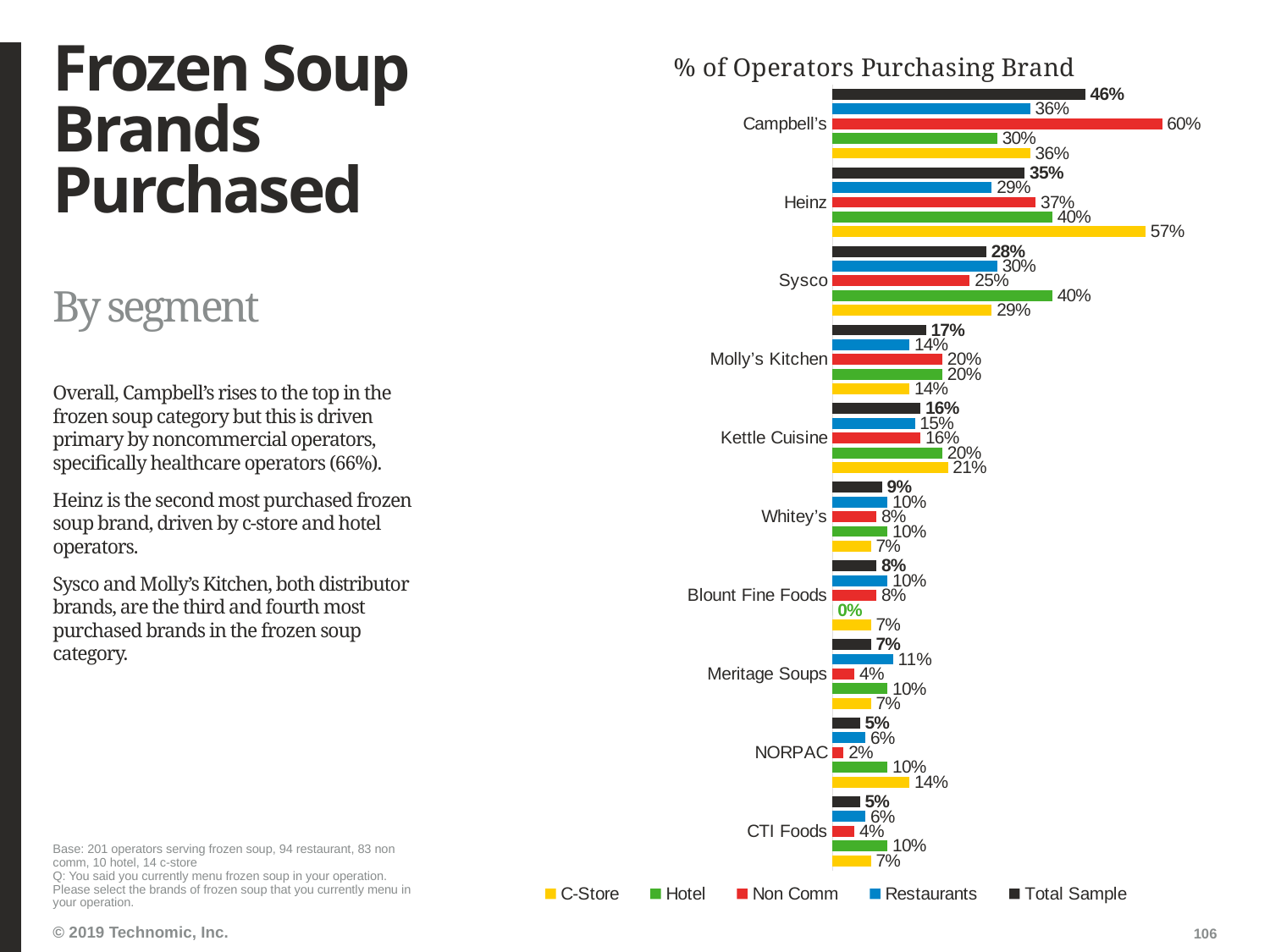
Which brand has the lowest Non Comm percentage? NORPAC For Heinz, which segment has the larger value: C-Store or Restaurants? C-Store Which brand has the highest Total Sample percentage? Campbell's What is the title of the chart? % of Operators Purchasing Brand What is the difference between the Non Comm and Hotel values for Campbell's? 30% What is the Hotel value for Blount Fine Foods? 0% What is the C-Store value for Heinz? 57% How many brands are shown in the chart? 10 What type of chart is shown on the slide? Bar chart What is the Total Sample value for Sysco? 28% How many series does the legend list? 5 What percentage of Non Comm operators purchase Campbell's? 60%